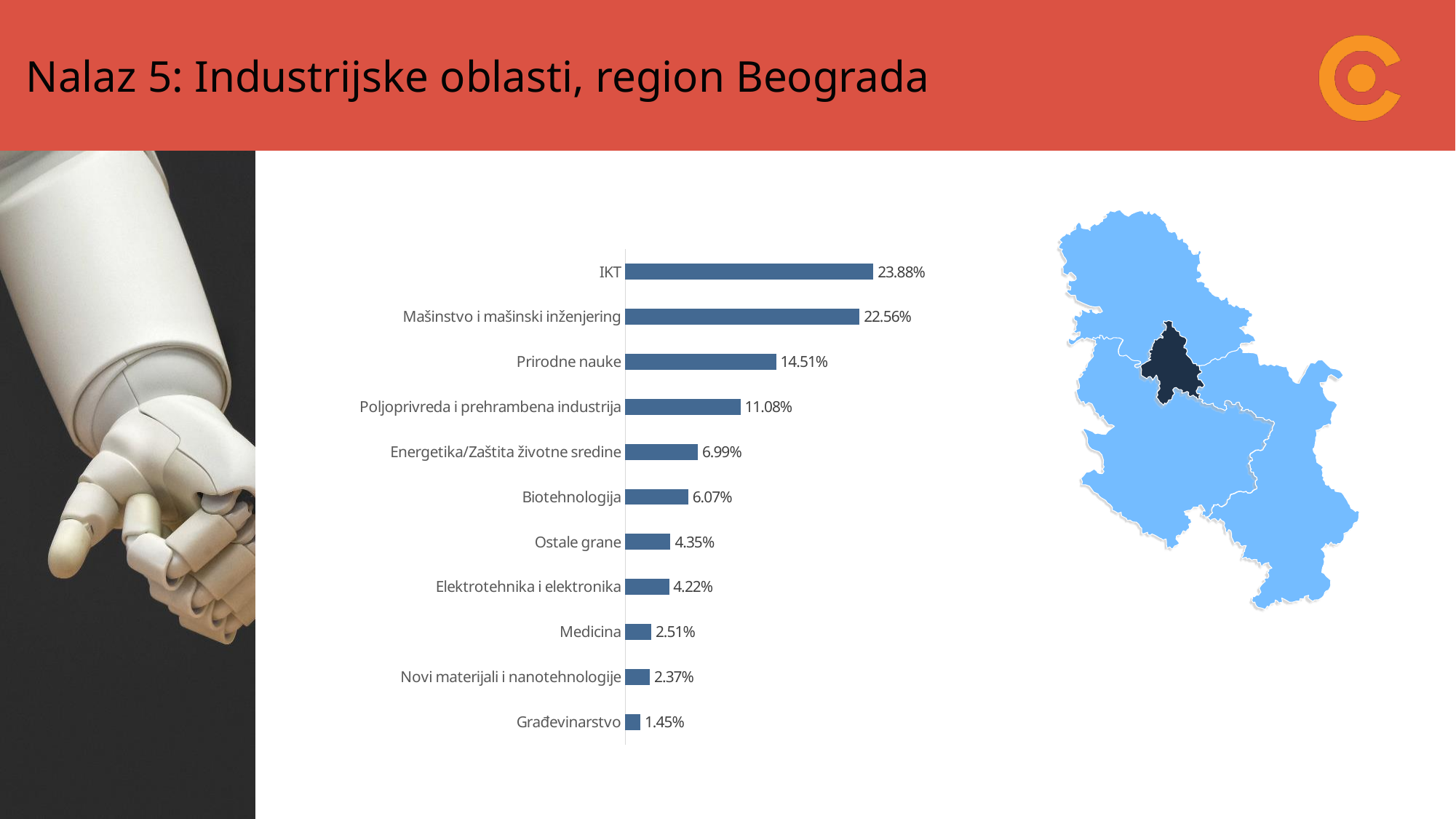
What kind of chart is shown on the slide? Bar chart Which category has the lowest value? Građevinarstvo What is the value for IKT? 23.88% What is the title of the slide? Nalaz 5: Industrijske oblasti, region Beograda How many categories are shown in the chart? 11 What is the difference between the values for Prirodne nauke and Poljoprivreda i prehrambena industrija? 3.43% What is the value for Biotehnologija? 6.07% What is the value for Prirodne nauke? 14.51% What is the value for Građevinarstvo? 1.45% Which is larger, the value for Energetika/Zaštita životne sredine or the value for Biotehnologija? Energetika/Zaštita životne sredine What is the difference between the values for IKT and Mašinstvo i mašinski inženjering? 1.32% Which category has the highest value? IKT